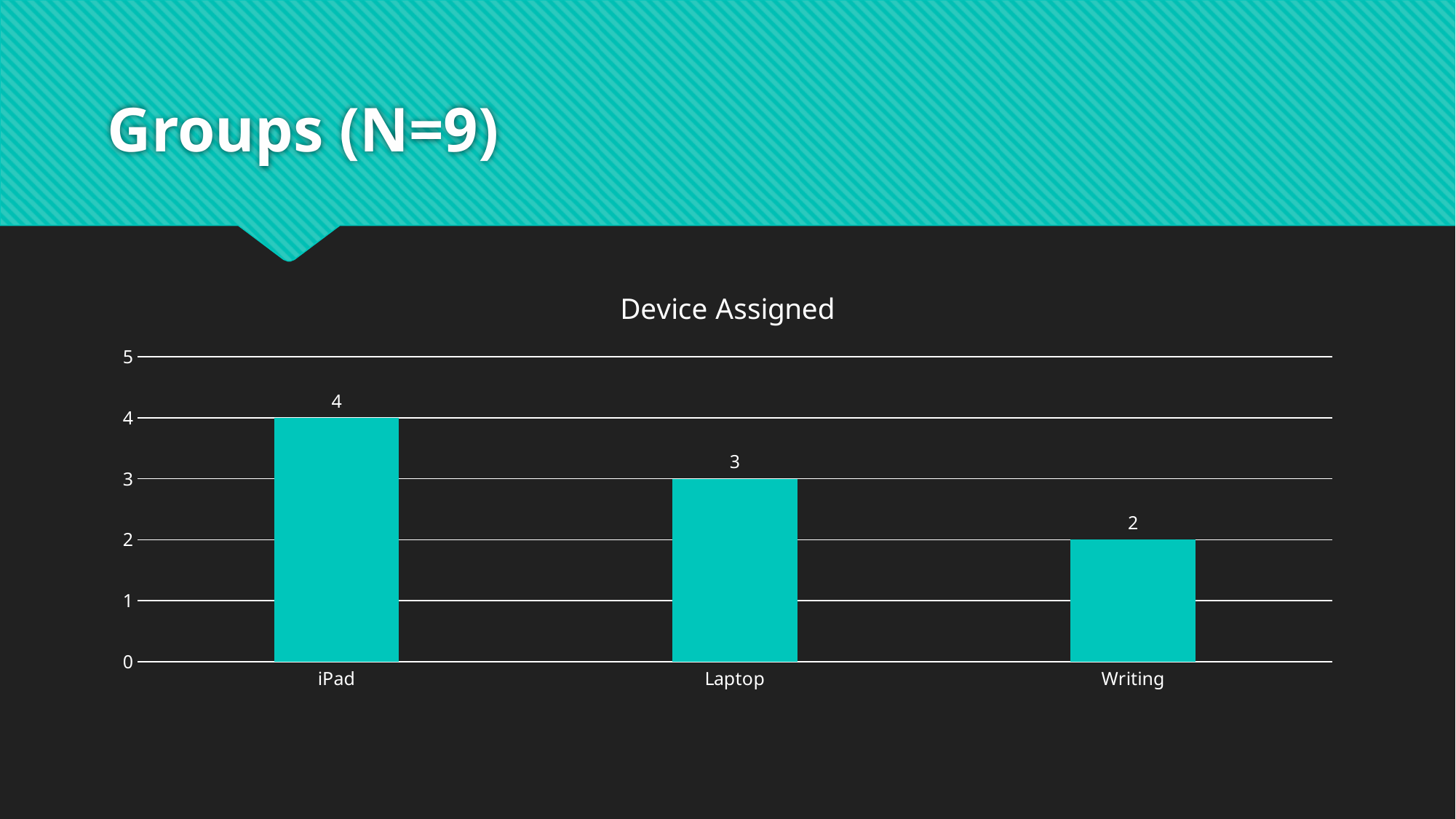
Which category has the highest value? iPad How many categories are shown on the x axis? 3 What is the difference between the values for iPad and Writing? 2 What is the value for iPad? 4 Which category has the lowest value? Writing What is the value for Laptop? 3 Do the values rise or fall from left to right along the x axis? Fall What is the difference between the values for iPad and Laptop? 1 Which is larger, the value for Laptop or the value for Writing? Laptop What kind of chart is shown on the slide? Bar chart What is the title of the chart? Device Assigned What is the value for Writing? 2